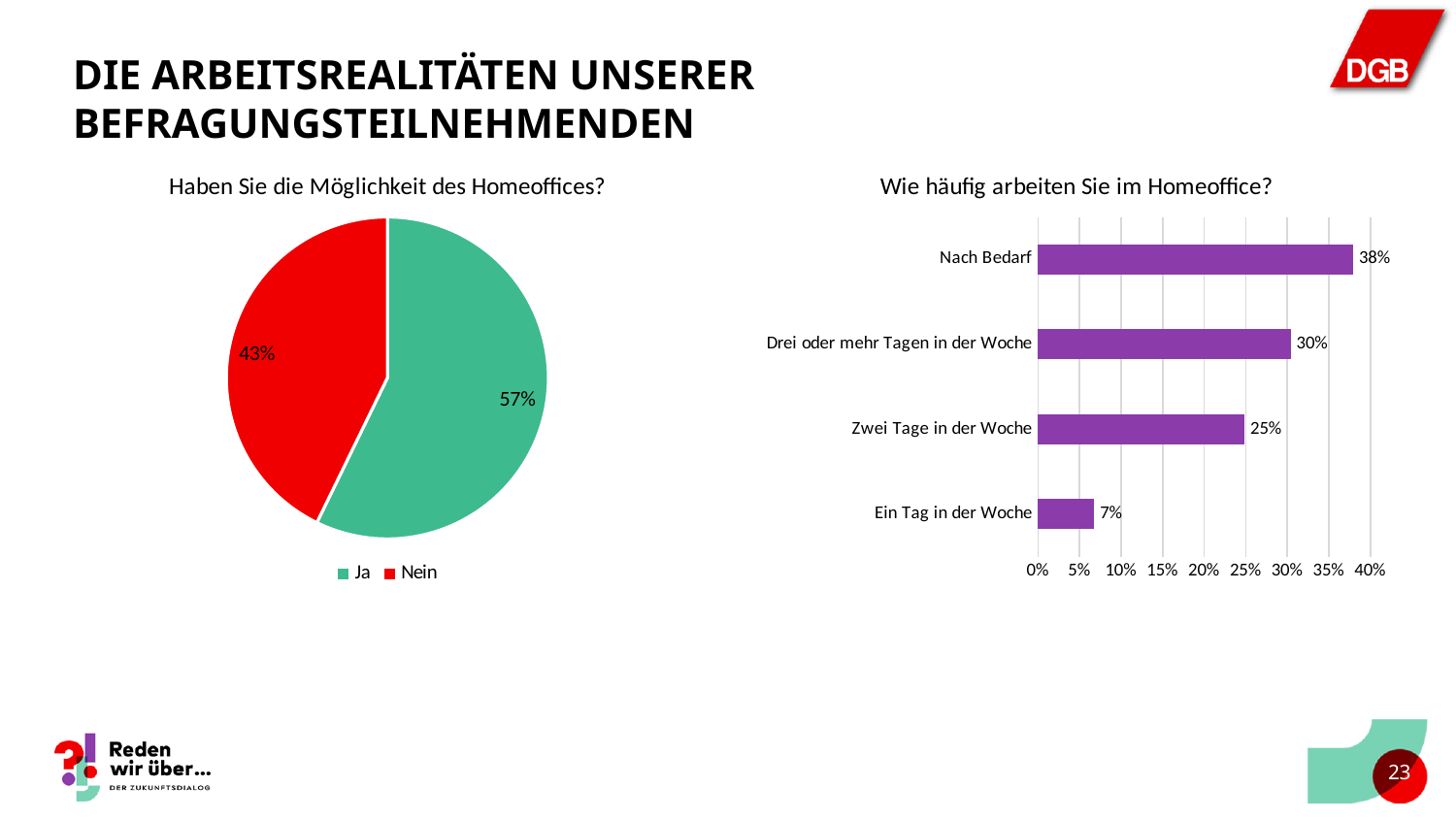
In the chart 'Wie häufig arbeiten Sie im Homeoffice?', which category has the lowest value? Ein Tag in der Woche What kind of chart is 'Wie häufig arbeiten Sie im Homeoffice?'? Bar chart In the pie chart 'Haben Sie die Möglichkeit des Homeoffices?', what is the difference in percentage points between 'Ja' and 'Nein'? 14 percentage points In the pie chart 'Haben Sie die Möglichkeit des Homeoffices?', how many entries does the legend list? 2 In the chart 'Wie häufig arbeiten Sie im Homeoffice?', which category has the highest value? Nach Bedarf In the chart 'Wie häufig arbeiten Sie im Homeoffice?', what is the difference between 'Drei oder mehr Tagen in der Woche' and 'Ein Tag in der Woche'? 23 percentage points In the pie chart 'Haben Sie die Möglichkeit des Homeoffices?', what share of respondents answered 'Nein'? 43% In the pie chart 'Haben Sie die Möglichkeit des Homeoffices?', which answer has the larger share, 'Ja' or 'Nein'? Ja How many categories are shown in the chart 'Wie häufig arbeiten Sie im Homeoffice?'? 4 In the chart 'Wie häufig arbeiten Sie im Homeoffice?', what is the value for 'Zwei Tage in der Woche'? 25% In the pie chart 'Haben Sie die Möglichkeit des Homeoffices?', what share of respondents answered 'Ja'? 57% In the chart 'Wie häufig arbeiten Sie im Homeoffice?', what is the value for 'Nach Bedarf'? 38%